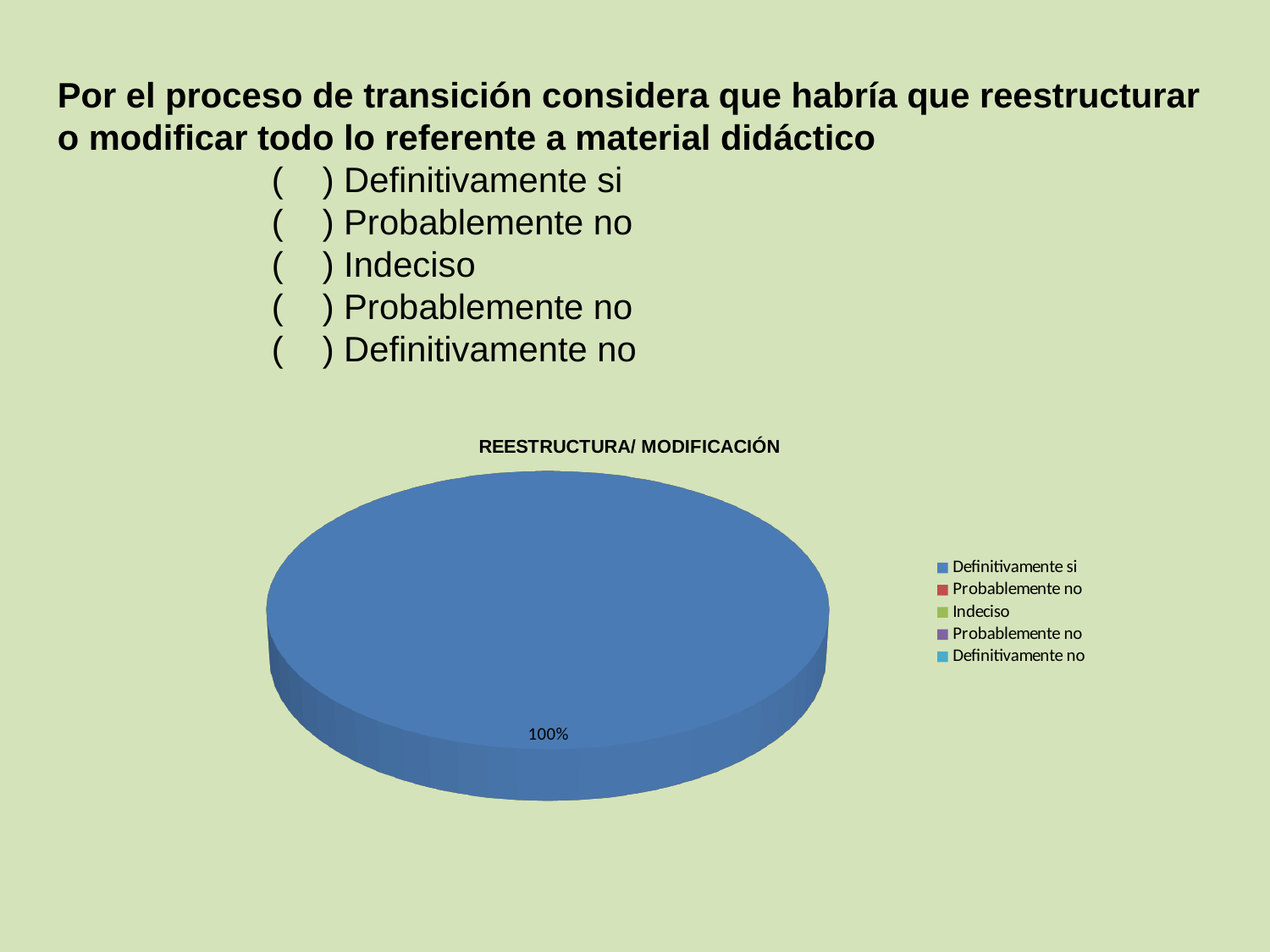
What share of the pie does the 'Definitivamente si' slice represent? 100% How many entries does the chart legend list? 5 What is the title of the chart? REESTRUCTURA/ MODIFICACIÓN How many slices are visible in the pie? 1 Which legend entry corresponds to the slice labelled 100%? Definitivamente si Which category has the largest share of the pie? Definitivamente si Is the share for 'Definitivamente si' greater or less than 50%? greater Which is larger, the share for 'Definitivamente si' or the share for 'Indeciso'? Definitivamente si What colour is the slice labelled 100%? blue What kind of chart is shown on the slide? pie chart